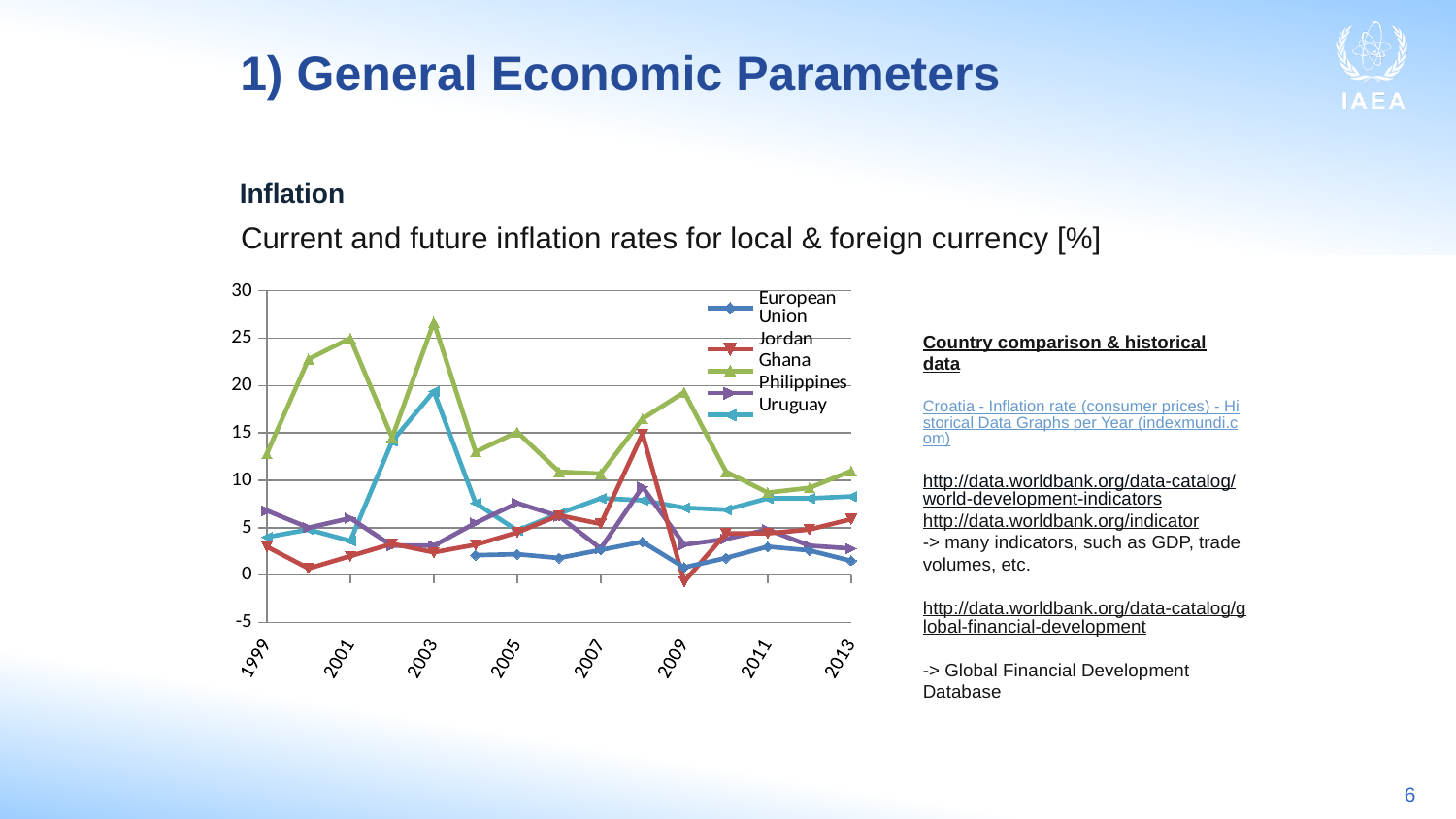
Which series are listed in the chart legend? European Union, Jordan, Ghana, Philippines, Uruguay Is the value for Ghana in 1999 greater or less than 10? greater How many year labels are shown on the x axis of the chart? 8 Is the value for Jordan in 2009 greater or less than 0? less Does the value for Ghana rise or fall between 2003 and 2007? fall What kind of chart is shown on the slide? Line chart Which series reaches the highest value anywhere on the chart? Ghana How many series does the chart legend list? 5 Which series has the lowest value in 2009? Jordan Is the value for Ghana in 2003 greater or less than 25? greater